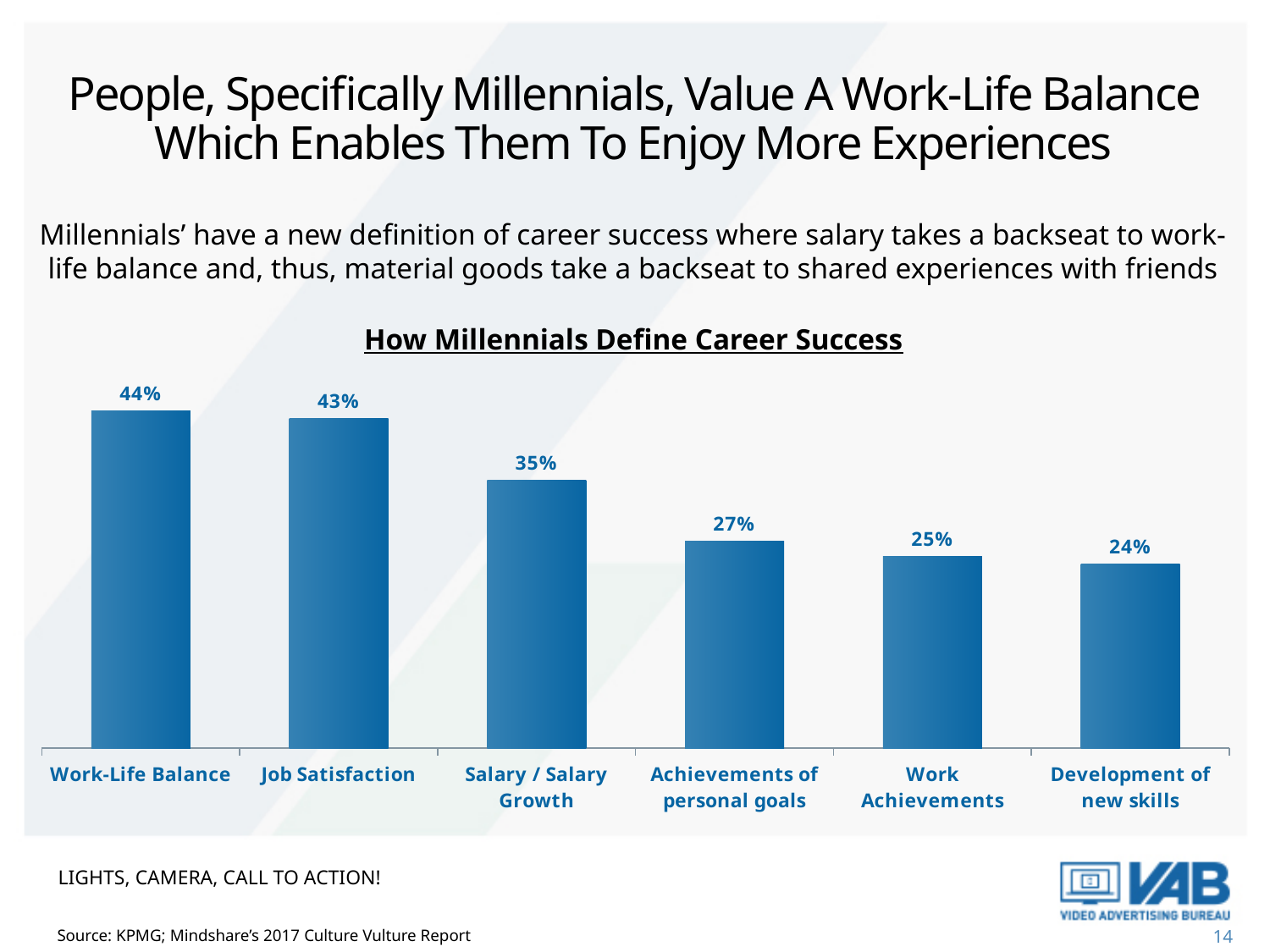
What is the difference between Work-Life Balance and Salary / Salary Growth? 9% What is the value for Salary / Salary Growth? 35% What is the value for Development of new skills? 24% How many categories are shown in the chart? 6 What kind of chart is shown on the slide? Bar chart What is the title of the chart? How Millennials Define Career Success Which is larger, Salary / Salary Growth or Achievements of personal goals? Salary / Salary Growth What is the difference between Achievements of personal goals and Work Achievements? 2% What is the value for Job Satisfaction? 43% Which category has the lowest value? Development of new skills Which category has the highest value? Work-Life Balance What percentage of millennials define career success as Work-Life Balance? 44%